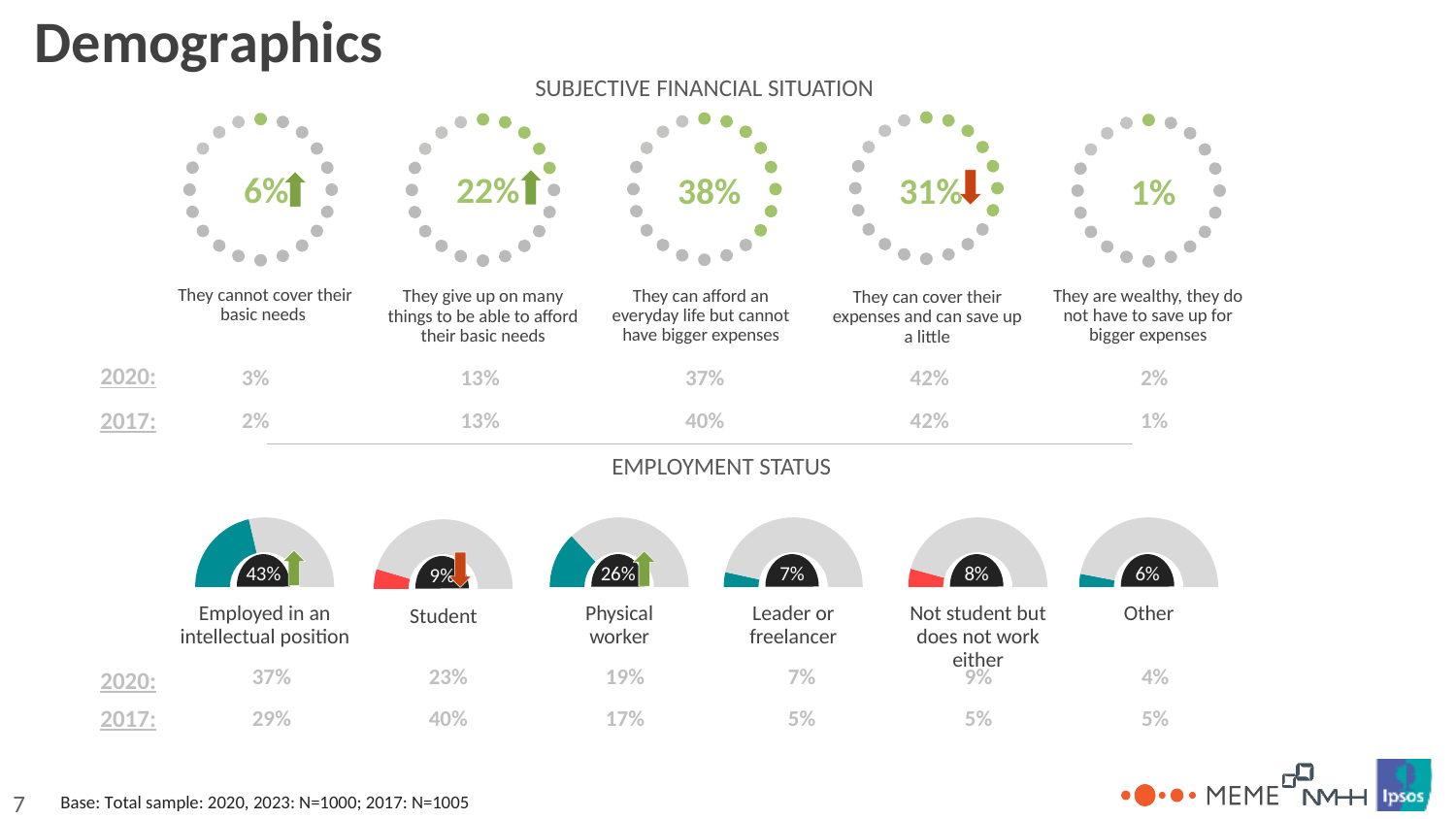
In the Subjective Financial Situation charts, which category has the lowest current percentage? They are wealthy, they do not have to save up for bigger expenses In the Employment Status charts, is the current value for 'Student' larger or smaller than the current value for 'Physical worker'? smaller In the Subjective Financial Situation charts, what is the current percentage for 'They can afford an everyday life but cannot have bigger expenses'? 38% In the Subjective Financial Situation section, what was the 2020 value for 'They can cover their expenses and can save up a little'? 42% How many categories are shown in the Subjective Financial Situation charts? 5 In the Employment Status charts, what is the current percentage for 'Employed in an intellectual position'? 43% In the Subjective Financial Situation charts, which category has the highest current percentage? They can afford an everyday life but cannot have bigger expenses In the Employment Status charts, which category has the highest current percentage? Employed in an intellectual position In the Employment Status section, what was the 2017 value for 'Student'? 40% How many categories are shown in the Employment Status charts? 6 In the Subjective Financial Situation charts, what is the difference between the current value for 'They can afford an everyday life but cannot have bigger expenses' and 'They can cover their expenses and can save up a little'? 7% In the Subjective Financial Situation charts, what is the current percentage for 'They cannot cover their basic needs'? 6%